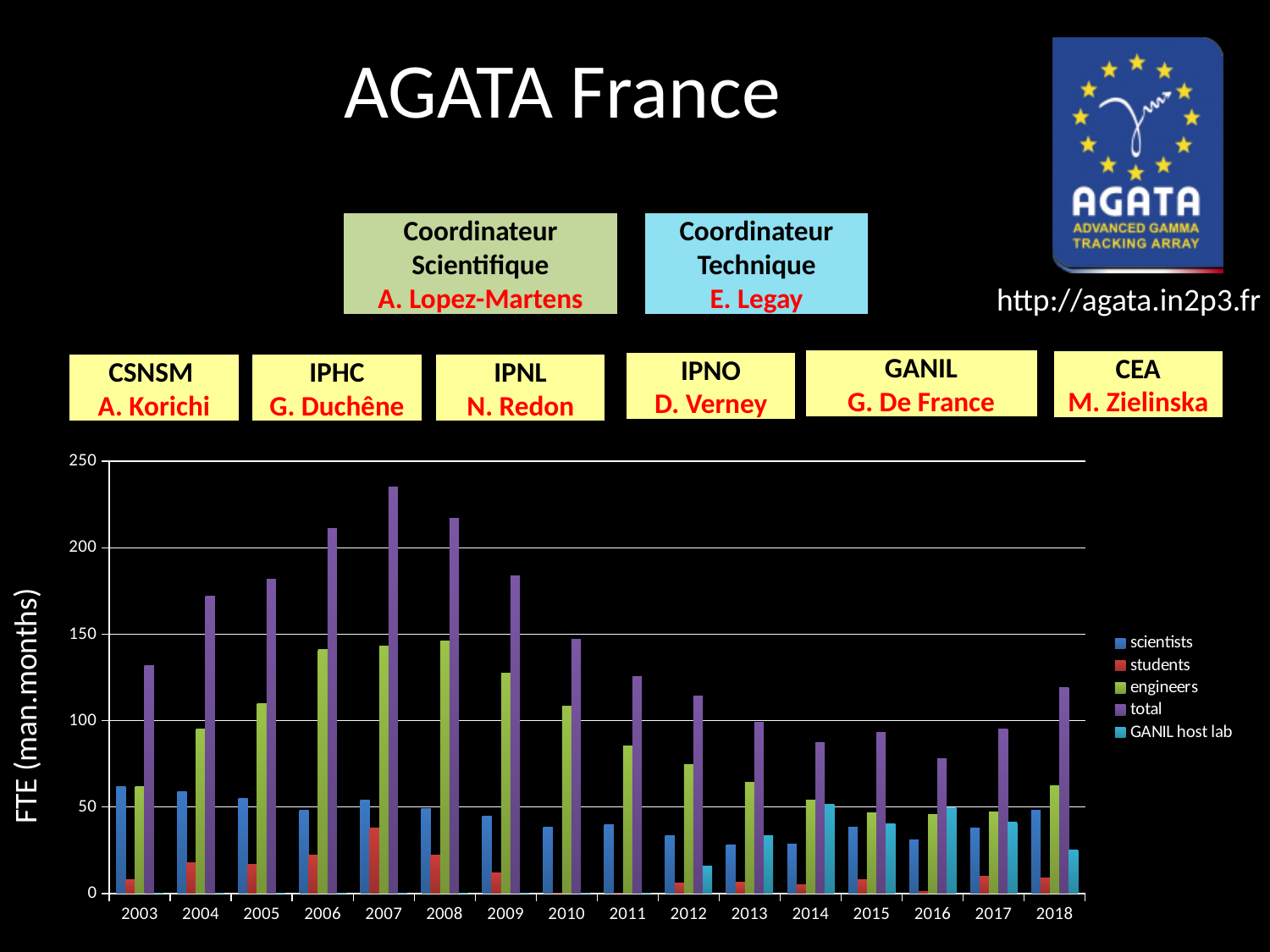
Is the engineers value for 2012 greater or less than 50? greater Is the total value for 2007 greater or less than 200? greater Which year has the larger engineers value, 2008 or 2013? 2008 What kind of chart is shown on the slide? bar chart What is the label on the y axis of the chart? FTE (man.months) In which year is the total bar the lowest? 2016 How many years are shown along the x axis of the chart? 16 In which year is the total bar the highest? 2007 Is the total value for 2016 greater or less than 100? less Which year has the larger total value, 2006 or 2010? 2006 Does the total series rise or fall from 2007 to 2016? fall How many series does the chart's legend list? 5